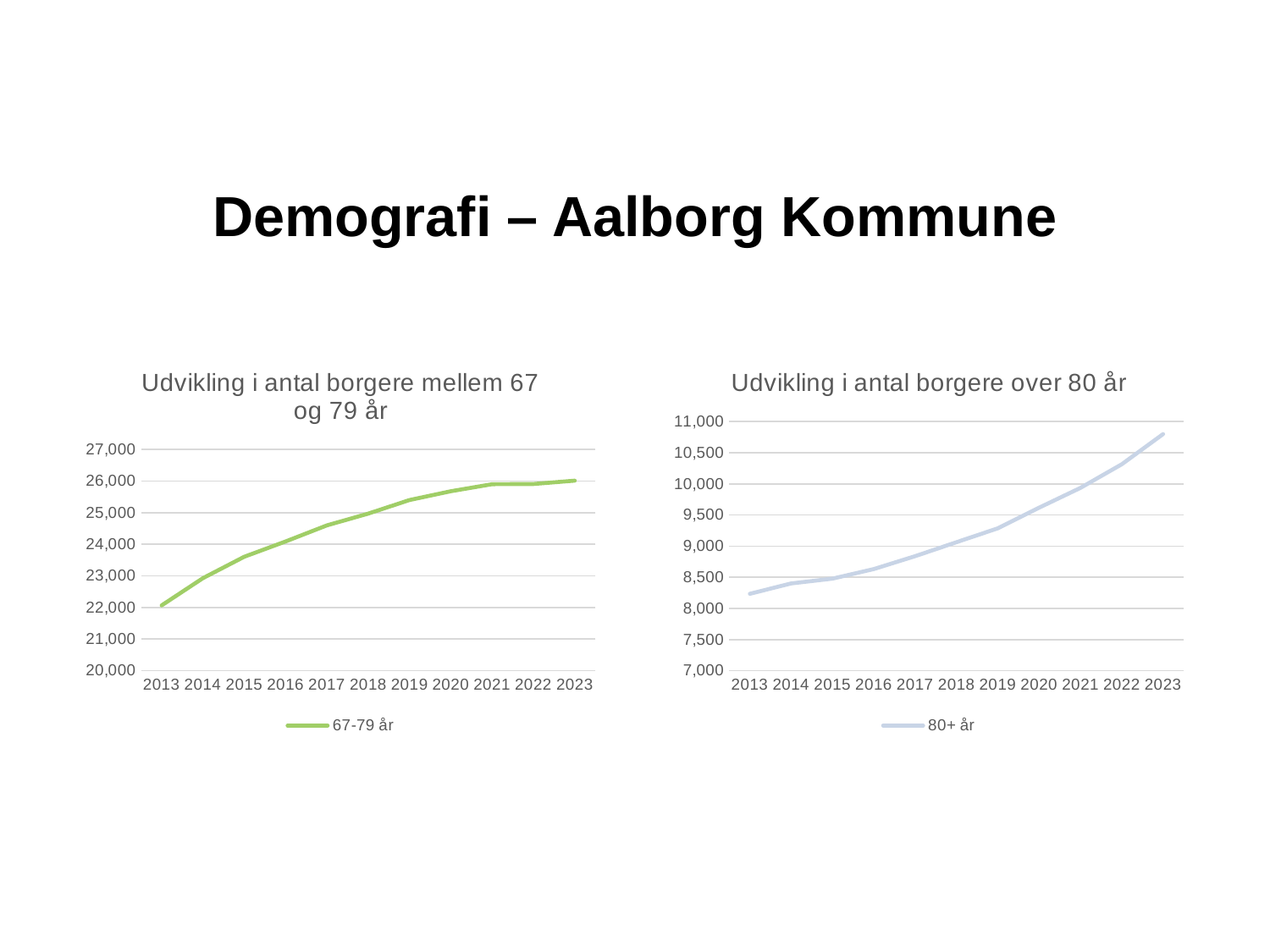
How many series does the legend of the left chart list? 1 In the left chart, 'Udvikling i antal borgere mellem 67 og 79 år', which year has the lowest value? 2013 In the right chart, 'Udvikling i antal borgere over 80 år', do the values rise or fall from 2013 to 2023? rise In the left chart, is the value for 2023 greater or less than 25,000? greater In the left chart, is the value for 2013 greater or less than 23,000? less In the right chart, is the value for 2023 greater or less than 10,500? greater In the right chart, 'Udvikling i antal borgere over 80 år', which year has the highest value? 2023 What kind of chart is the left chart, 'Udvikling i antal borgere mellem 67 og 79 år'? line chart In the left chart, which year has the larger value, 2015 or 2020? 2020 How many years are shown on the x axis of the right chart, 'Udvikling i antal borgere over 80 år'? 11 What is the legend entry of the right chart? 80+ år